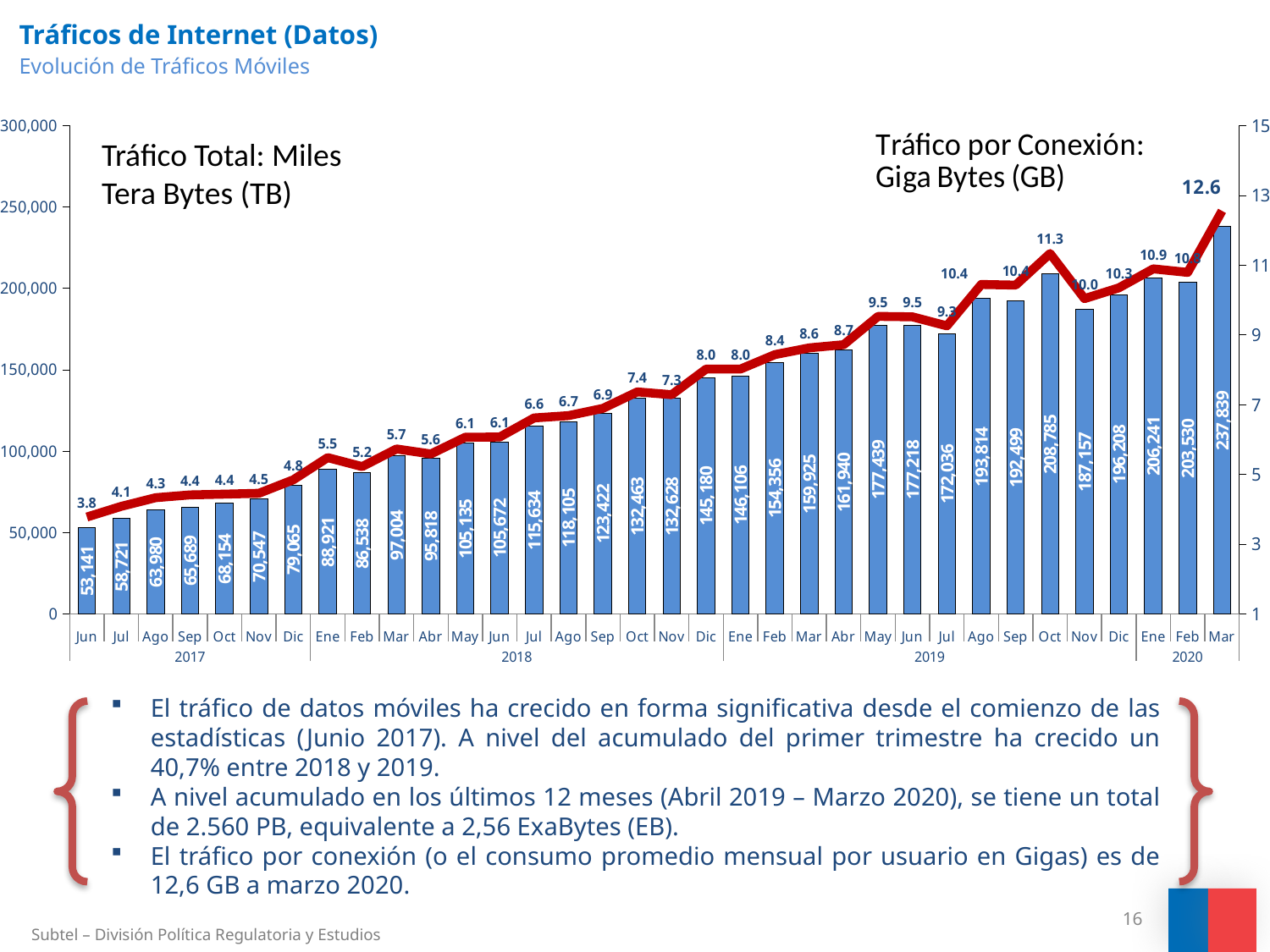
Is the total traffic bar for Dic 2018 greater or less than 150,000? less What is the total traffic value (miles TB) shown for Mar 2020? 237,839 How many months are plotted on the x axis? 34 Does the traffic per connection line generally rise or fall from Jun 2017 to Mar 2020? Rise Which month has the highest total traffic bar? Mar 2020 What is the difference in total traffic (miles TB) between Mar 2020 and Feb 2020? 34,309 What is the total traffic value (miles TB) shown for Oct 2019? 208,785 What is the traffic per connection (GB) shown for Jun 2017? 3.8 Which month has the lowest total traffic bar? Jun 2017 What is the traffic per connection (GB) shown for Oct 2019? 11.3 What kind of chart is used for the total traffic (Tráfico Total) series? Bar chart Which has a larger total traffic bar, Oct 2019 or Nov 2019? Oct 2019